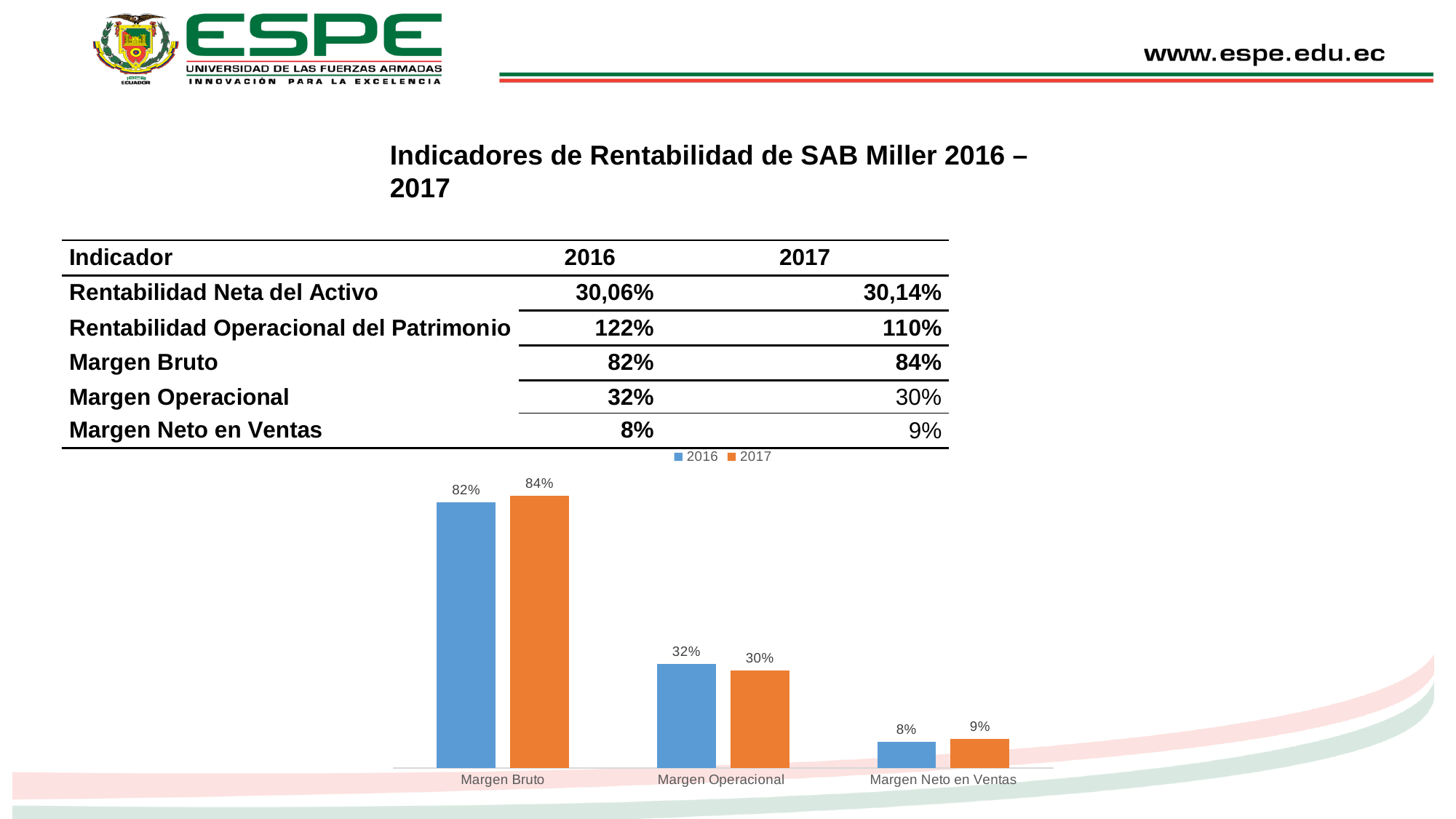
For Margen Neto en Ventas, which year has the larger value in the chart, 2016 or 2017? 2017 Which colour represents the 2017 series in the chart? Orange What is the value for Margen Operacional in 2017 in the chart? 30% Which category has the highest value for the 2017 series in the chart? Margen Bruto What is the difference between the 2016 and 2017 values for Margen Operacional in the chart? 2% How many categories are shown on the x axis of the chart? 3 Which category has the lowest value for the 2016 series in the chart? Margen Neto en Ventas What kind of chart is shown on the slide? Bar chart What is the value for Margen Bruto in 2016 in the chart? 82% What is the difference between the 2017 and 2016 values for Margen Bruto in the chart? 2% What is the value for Margen Neto en Ventas in 2016 in the chart? 8% How many series does the chart legend list? 2